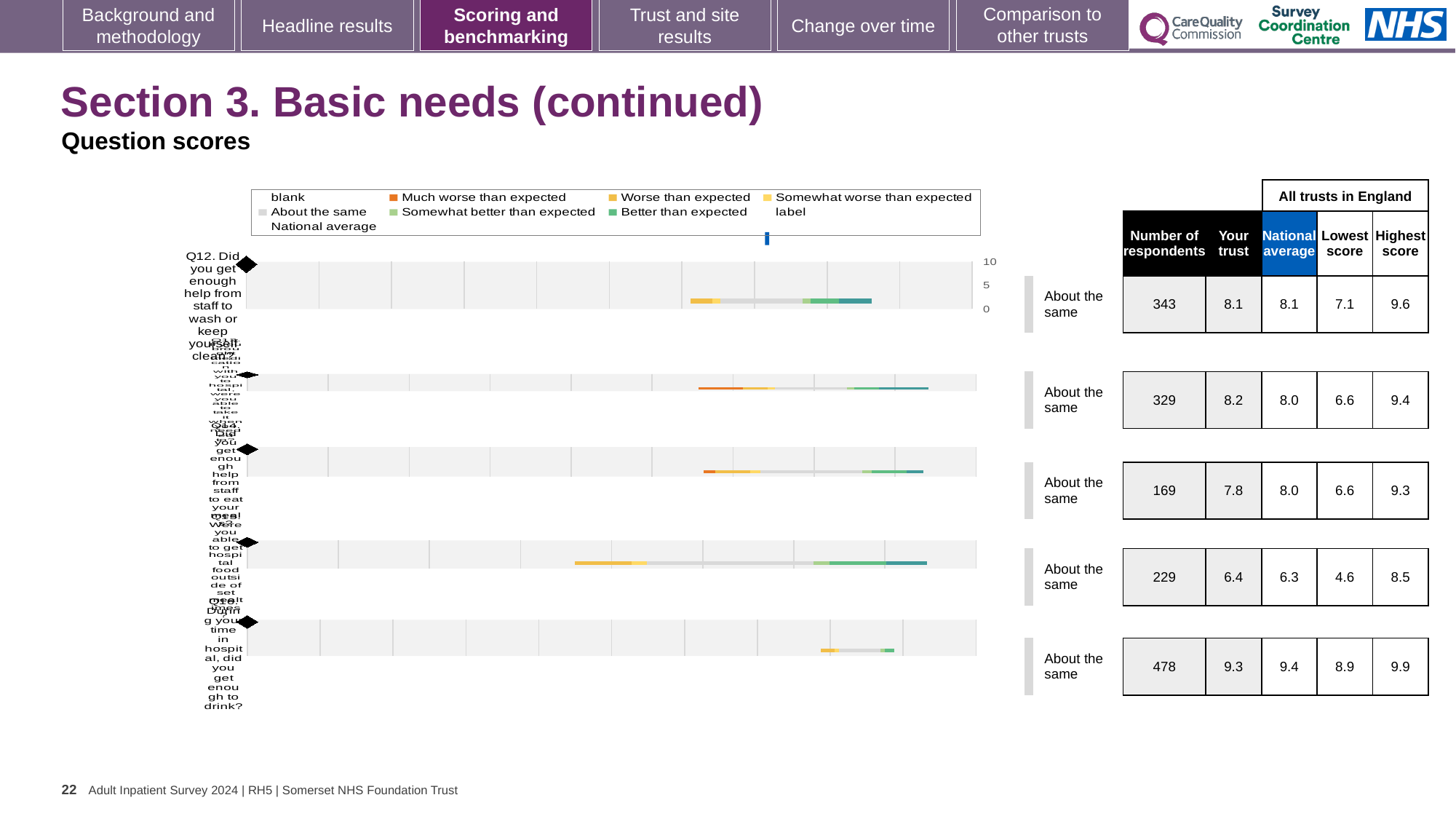
How many question rows (bars) does the chart show? 5 In the table beside the chart, what is the national average for Q12 (the top row)? 8.1 Which row has the highest 'Your trust' score in the table beside the chart? the bottom (fifth) row, 9.3 What is the label of the first (top) bar in the chart? Q12. Did you get enough help from staff to wash or keep yourself clean? What colour does the legend use for 'Much worse than expected'? orange In the table beside the chart, what is the 'Your trust' score for Q12 (the top row)? 8.1 In the table beside the chart, what is the highest score for Q12 (the top row)? 9.6 In the table beside the chart, how many respondents are listed for Q12 (the top row)? 343 Which row has the lowest 'Your trust' score in the table beside the chart? the fourth row, 6.4 What is the difference between the highest score and the lowest score for Q12 (the top row) in the table? 2.5 What kind of chart is shown on the slide? bar chart Is the 'Your trust' score for the second row (8.2) larger or smaller than its national average (8.0)? larger